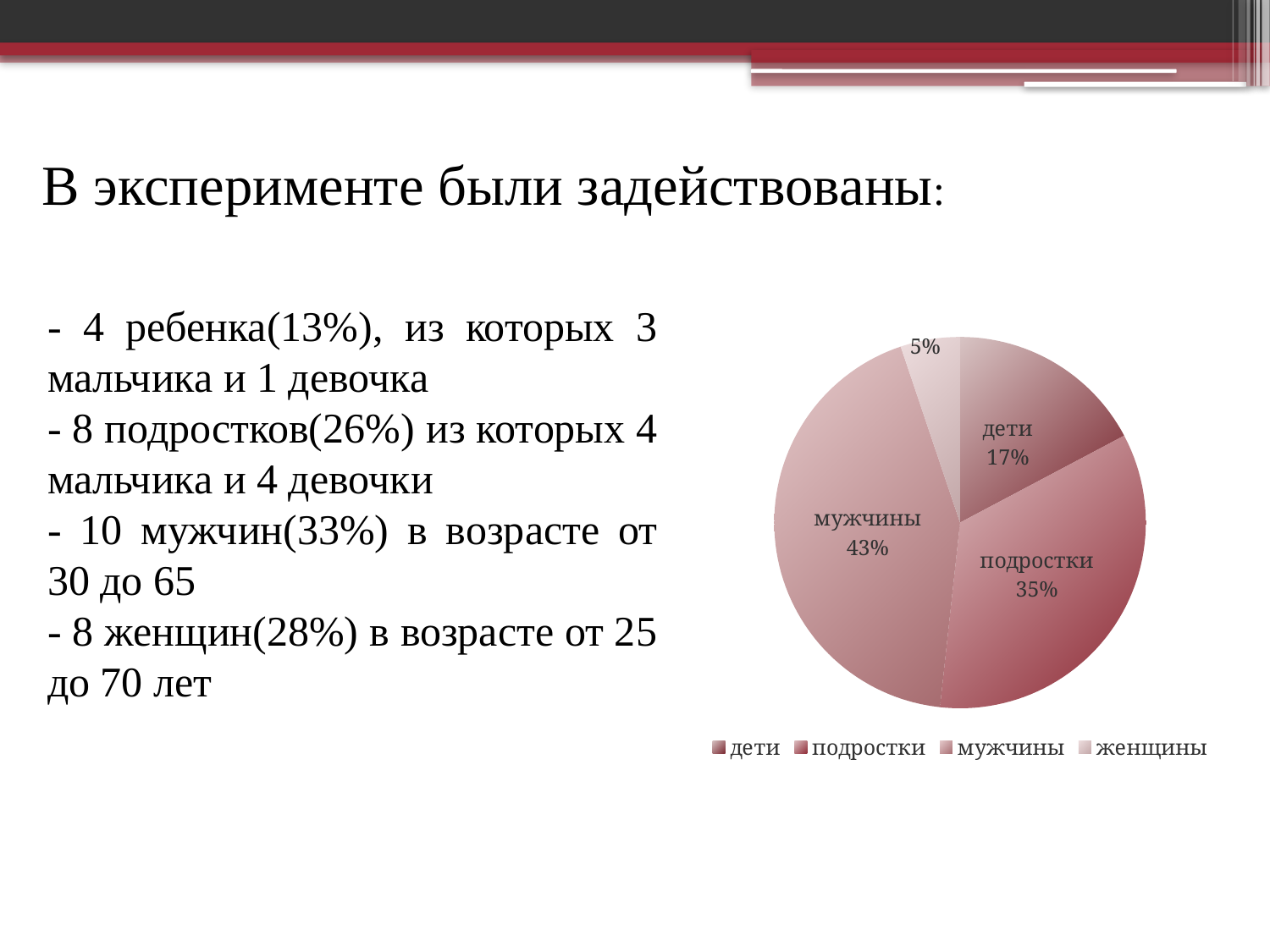
What percentage of the pie chart is labelled for дети? 17% Which slice is larger in the pie chart, дети or подростки? подростки What is the difference in percentage points between the мужчины slice and the подростки slice? 8 Which category is listed last in the legend of the pie chart? женщины How many slices does the pie chart have? 4 What percentage is shown on the smallest slice of the pie chart? 5% What percentage of the pie chart is labelled for мужчины? 43% What percentage of the pie chart is labelled for подростки? 35% What kind of chart is shown on the slide? pie chart Which category has the largest slice in the pie chart? мужчины How many entries does the legend of the pie chart list? 4 Which category has the smallest slice in the pie chart? женщины